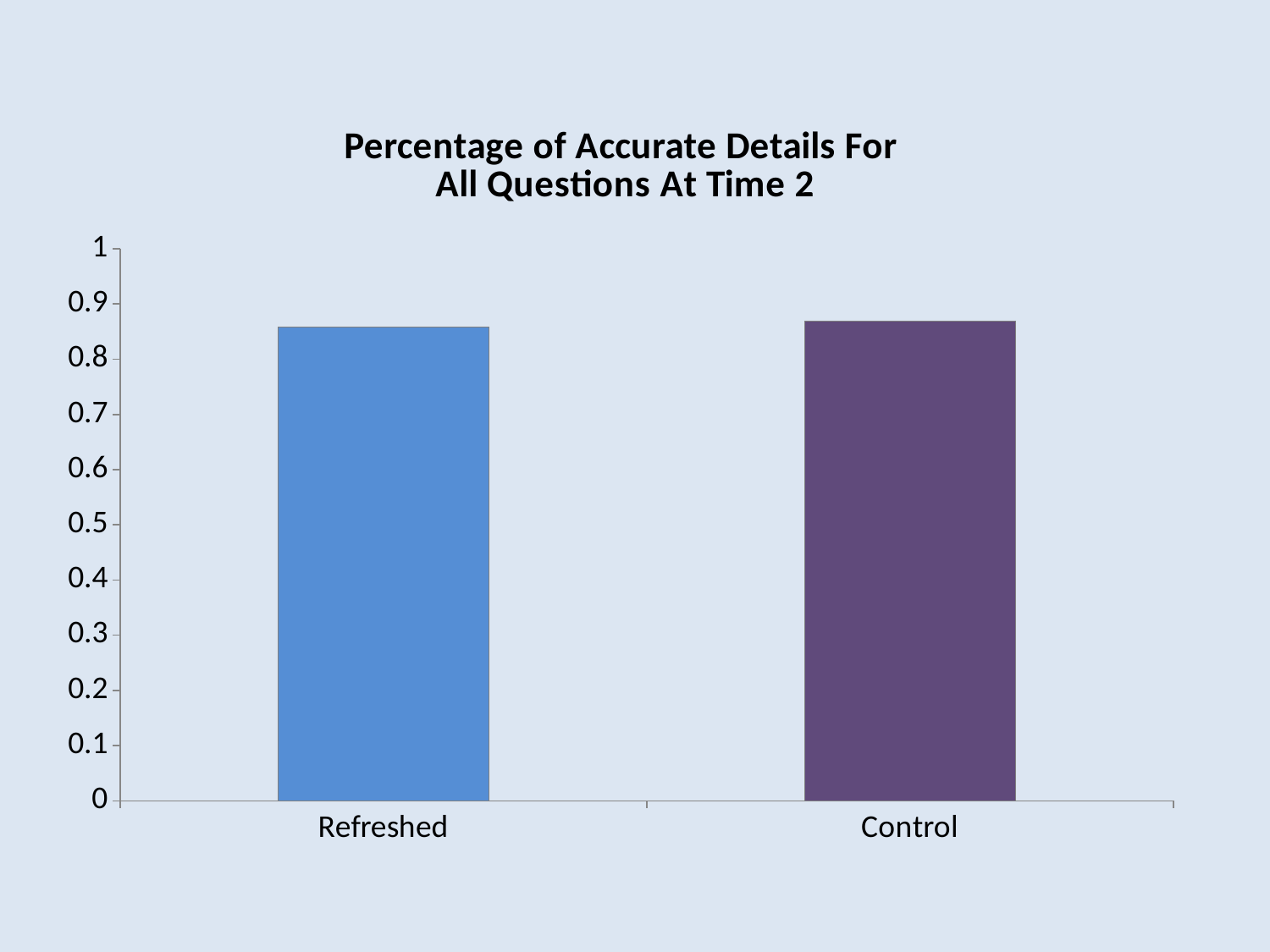
Is the value for Refreshed greater or less than 0.5? greater Is the value for Control greater or less than 0.8? greater Is the value for Refreshed greater or less than 0.8? greater What is the title of the chart? Percentage of Accurate Details For All Questions At Time 2 What are the two categories shown on the x axis? Refreshed and Control What kind of chart is shown on the slide? bar chart How many categories are plotted on the chart? 2